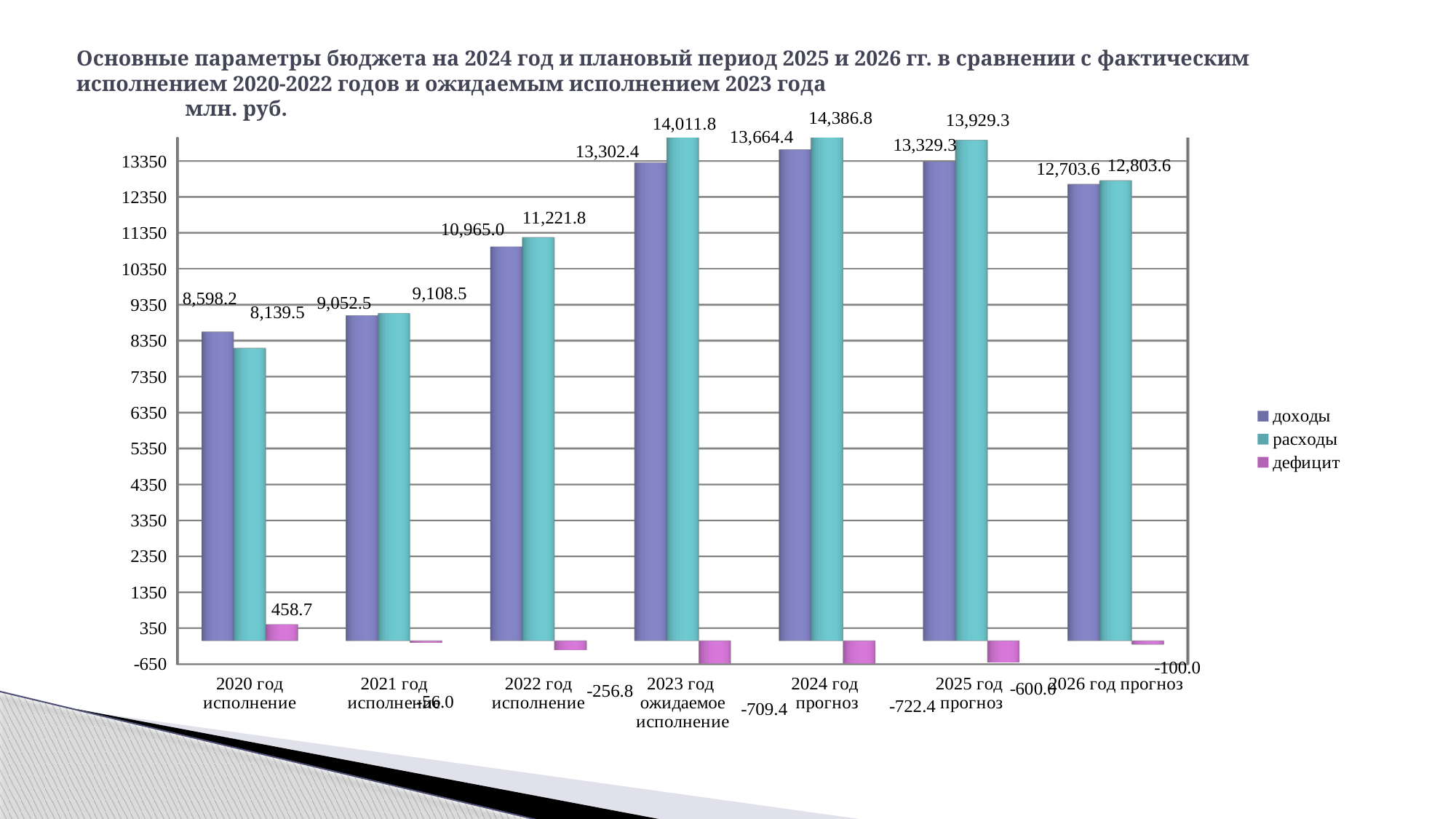
How many series does the legend list? 3 Which category has the lowest value of доходы? 2020 год исполнение Which category has the highest value of расходы? 2024 год прогноз What is the value of дефицит for 2023 год ожидаемое исполнение? -709.4 What is the value of доходы for 2026 год прогноз? 12,703.6 What is the value of расходы for 2024 год прогноз? 14,386.8 Which is larger for 2022 год исполнение, доходы or расходы? расходы What is the value of доходы for 2020 год исполнение? 8,598.2 How many categories are shown on the x axis? 7 What unit of measurement is indicated above the chart? млн. руб. What kind of chart is shown on the slide? bar chart What is the difference between расходы and доходы for 2025 год прогноз? 600.0